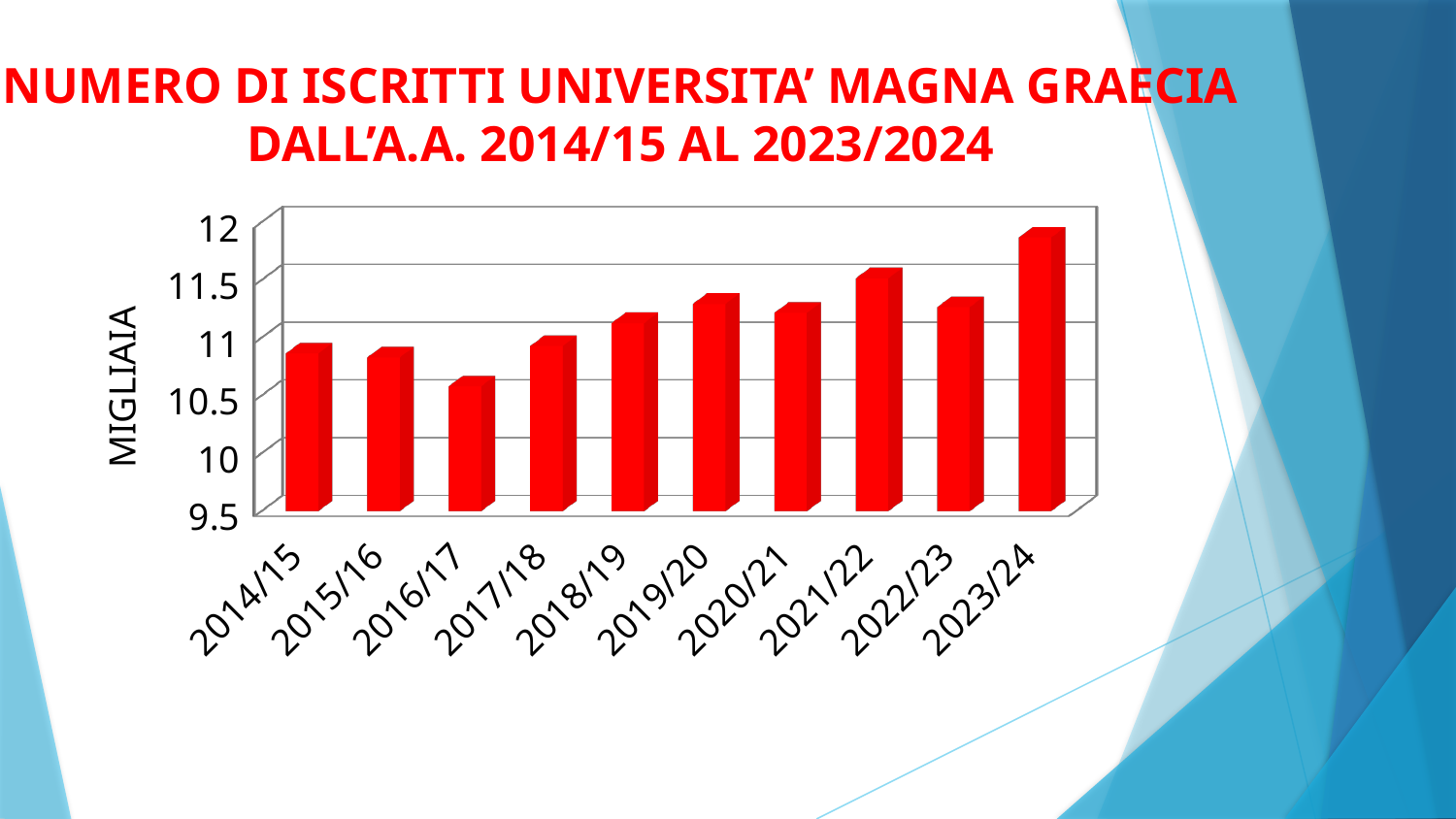
Is the value for 2016/17 greater or less than 11? less Is the value for 2022/23 greater or less than 11.5? less Which academic year has the highest number of enrolled students? 2023/24 Overall, do the values rise or fall from 2014/15 to 2023/24? Rise Is the value for 2021/22 greater or less than 11? greater Which is larger, the value for 2021/22 or the value for 2015/16? 2021/22 Which is larger, the value for 2014/15 or the value for 2016/17? 2014/15 What kind of chart is shown on the slide? Bar chart Which academic year has the lowest number of enrolled students? 2016/17 What is the label on the vertical axis of the chart? MIGLIAIA How many academic years are shown on the x axis of the chart? 10